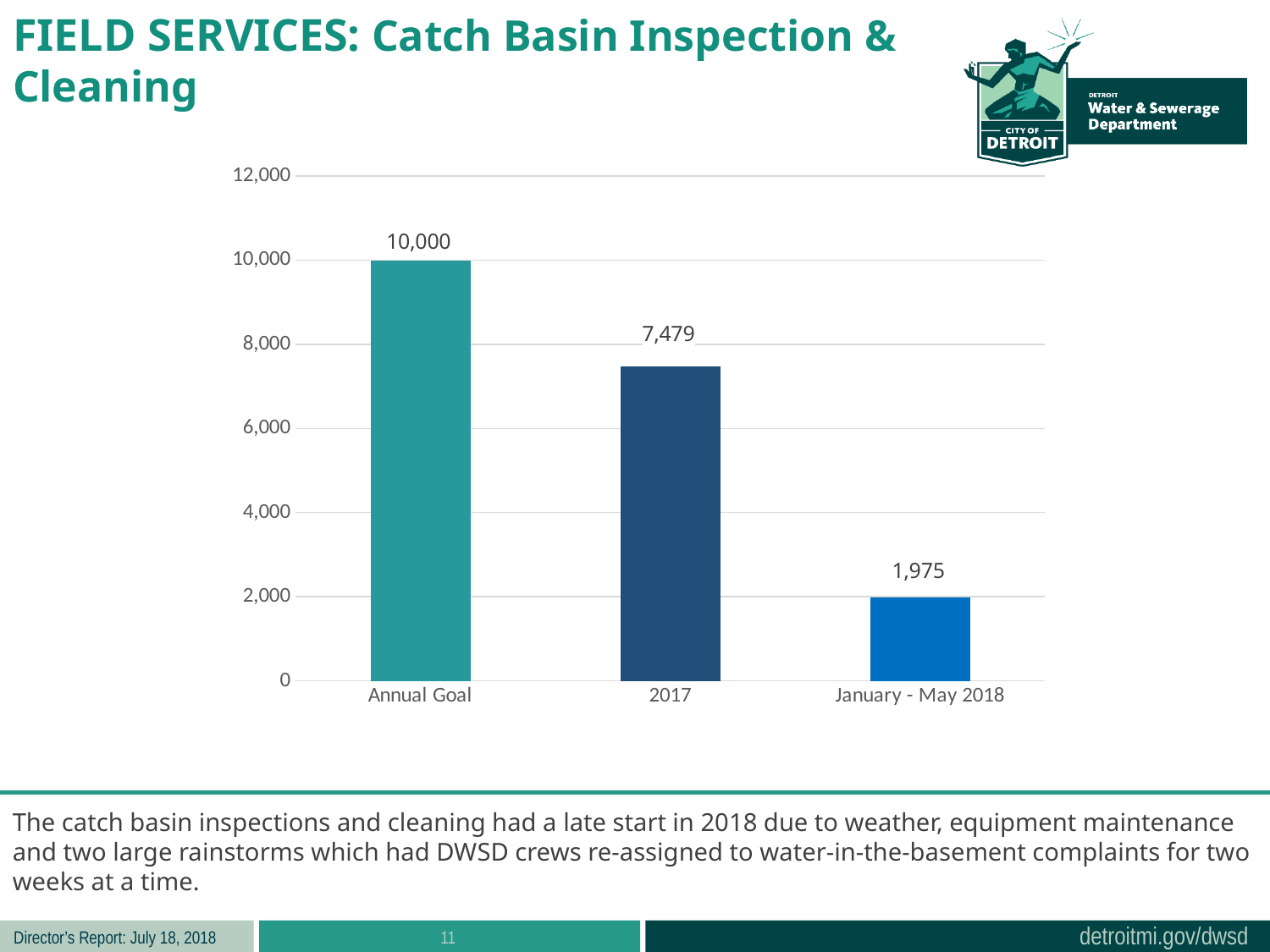
Which category has the lowest value? January - May 2018 What is the value for January - May 2018? 1,975 What kind of chart is shown on the slide? bar chart Is the value for 2017 greater or less than 8,000? less Do the values rise or fall from left to right along the x axis? fall What is the difference between the 2017 value and the January - May 2018 value? 5,504 How many categories are shown on the x axis? 3 Which is larger, the value for 2017 or the value for January - May 2018? 2017 What is the difference between the Annual Goal and the 2017 value? 2,521 Which category has the highest value? Annual Goal What is the value for Annual Goal? 10,000 What is the value for 2017? 7,479